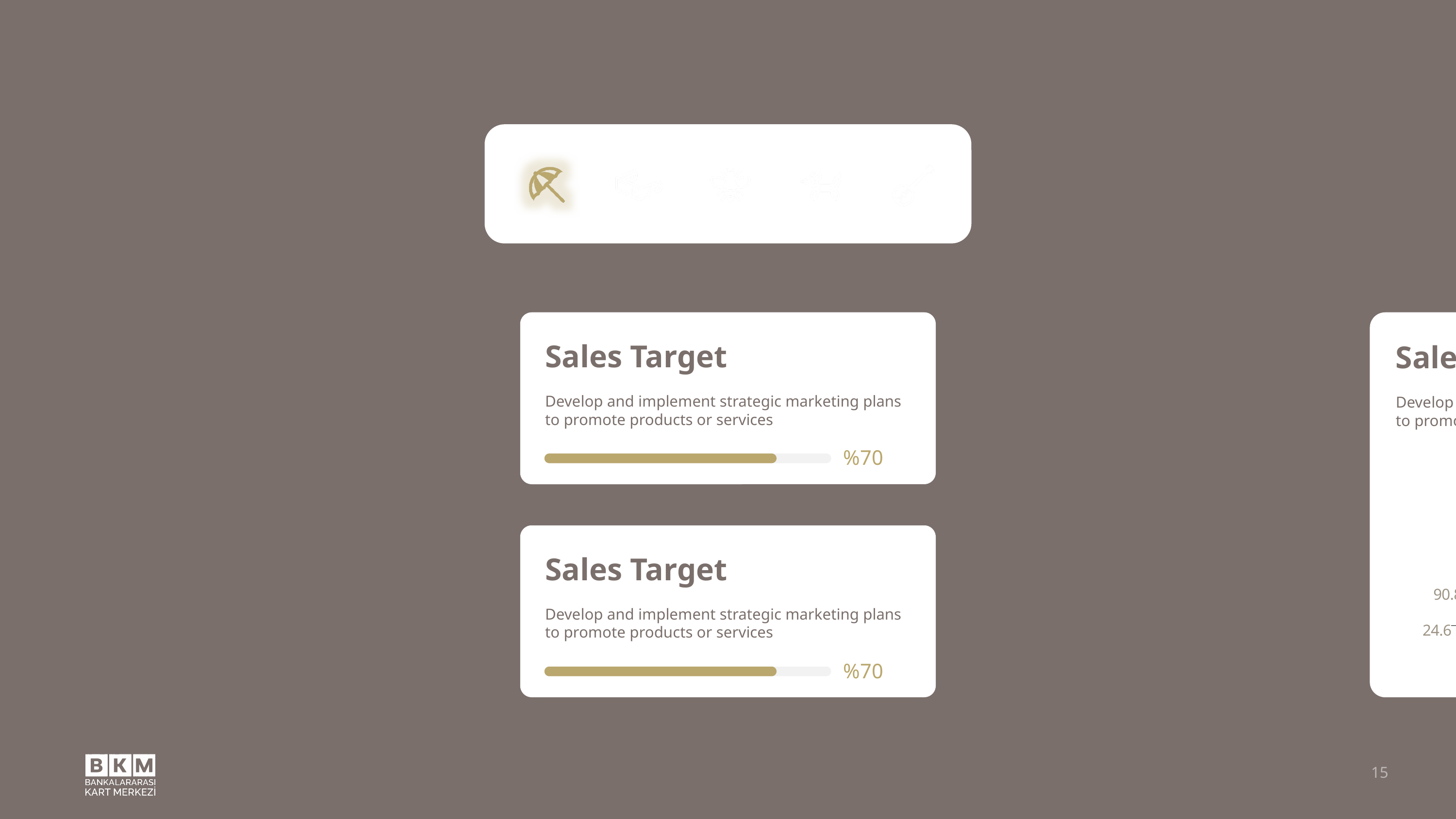
What colour is the filled portion of the progress bars on the slide? Gold How many Sales Target progress bars are fully visible on the slide? 2 What is the title of the card containing the top progress bar? Sales Target What percentage is shown on the progress bar in the top Sales Target card? %70 What is the difference between the percentage values of the top and bottom Sales Target progress bars? 0 What percentage is shown on the progress bar in the bottom Sales Target card? %70